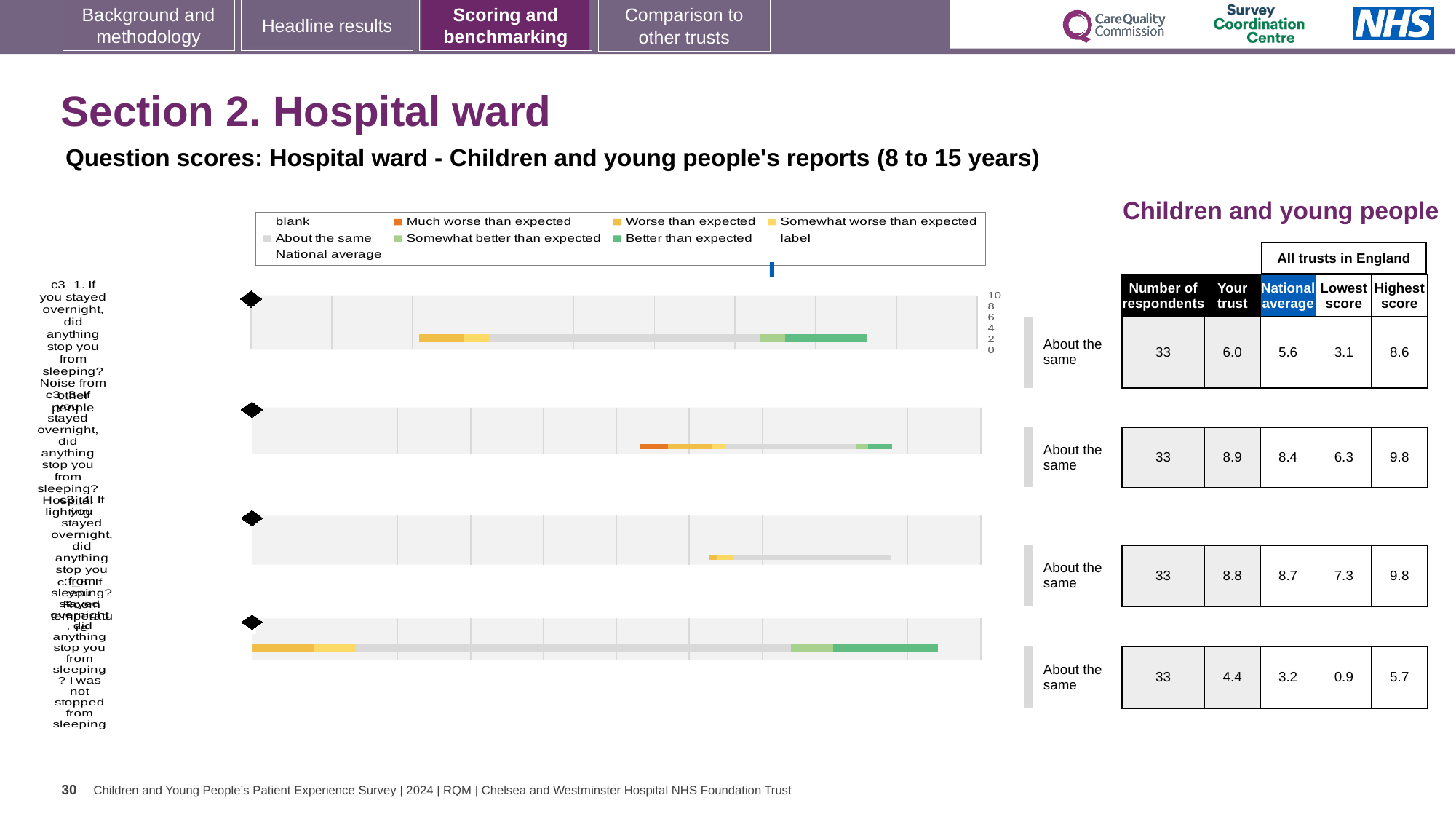
How many respondents are listed for the first (top) chart? 33 In the legend, what colour represents 'Better than expected'? green Which of the four charts has the lowest 'Your trust' score? the fourth (bottom) chart For the second chart, what is the 'National average' score in the table? 8.4 For the first (top) chart, what is the difference between the 'Your trust' score and the 'National average' score? 0.4 For the fourth (bottom) chart, which is larger: the 'Your trust' score or the 'National average' score? Your trust In the legend, what colour represents 'Much worse than expected'? orange What kind of chart is used for the four question-score charts on the slide? bar chart For the third chart, what is the 'Highest score' in the table? 9.8 How many question-score charts are shown on the slide? 4 For the fourth (bottom) chart, what is the 'Lowest score' in the table? 0.9 For the first (top) chart, what is the 'Your trust' score in the table? 6.0